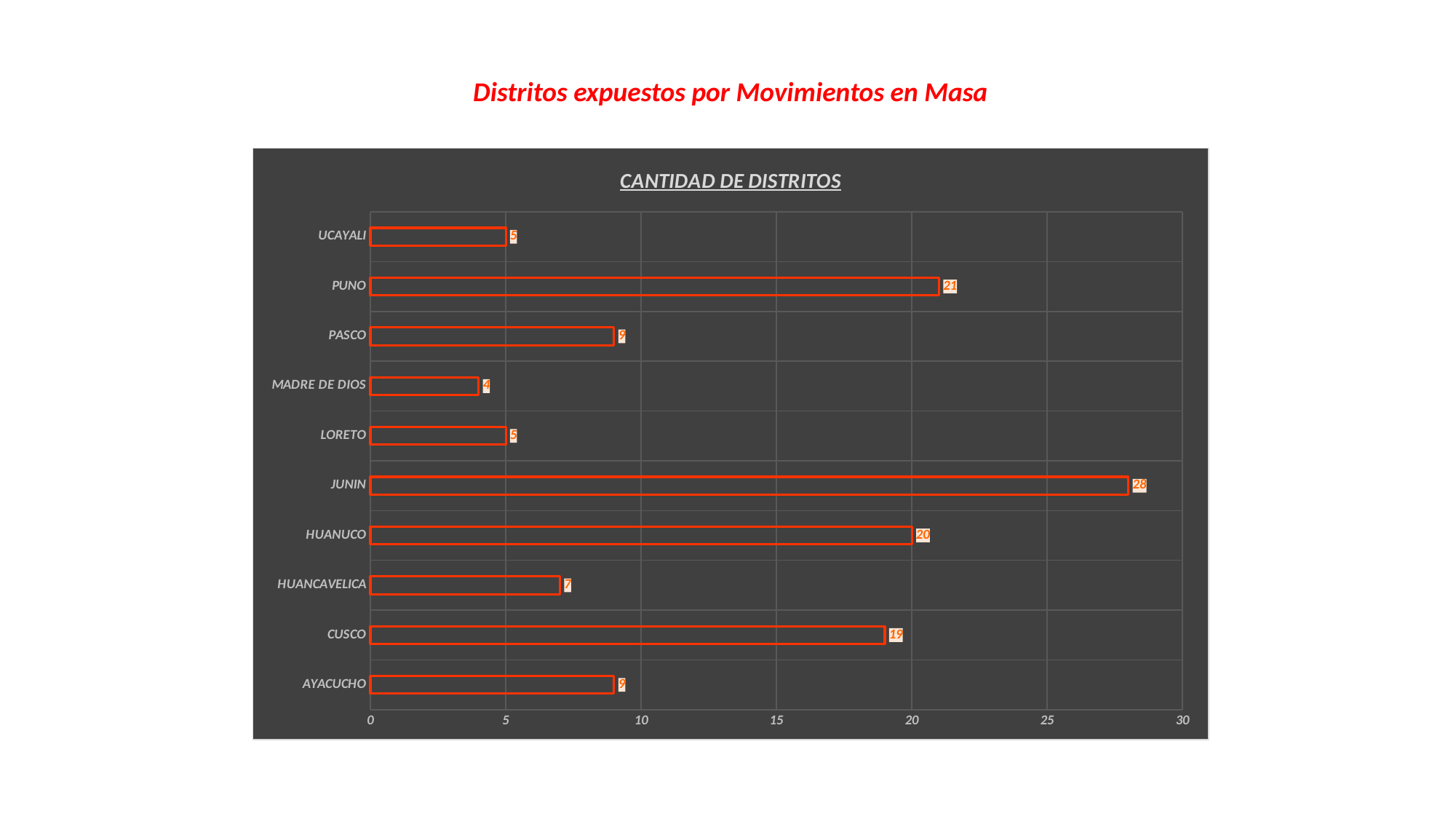
What is the value for MADRE DE DIOS? 4 What is the value for HUANCAVELICA? 7 Which category has the lowest value? MADRE DE DIOS Which is larger, the value for CUSCO or the value for HUANUCO? HUANUCO What is the title of the chart? CANTIDAD DE DISTRITOS What is the value for JUNIN? 28 Which category has the highest value? JUNIN What is the difference between the values for JUNIN and HUANUCO? 8 How many categories are shown in the chart? 10 Is the value for PASCO greater or less than 10? less What is the value for PUNO? 21 What kind of chart is shown on the slide? bar chart